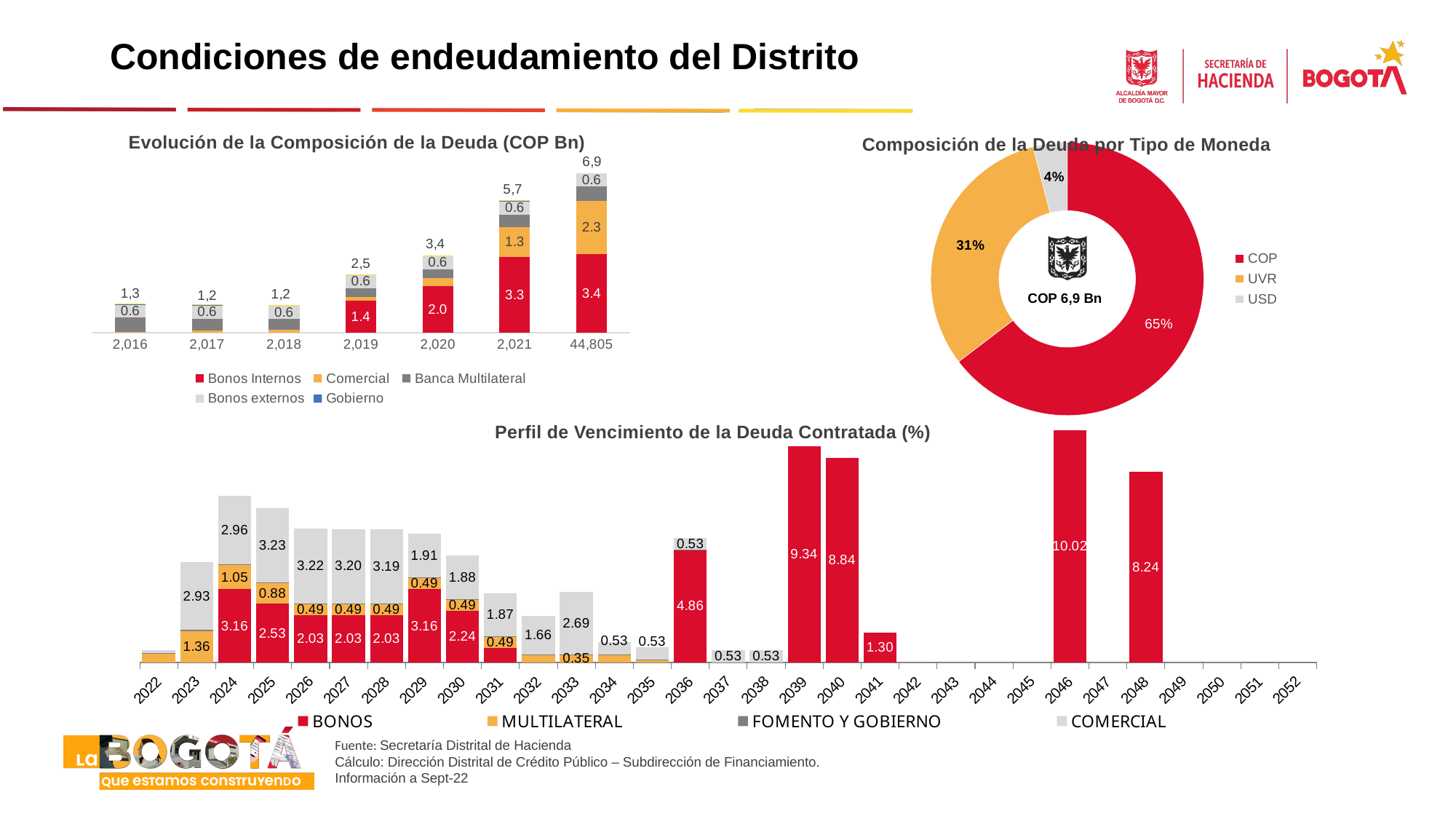
In the 'Composición de la Deuda por Tipo de Moneda' chart, what is the difference between the COP share and the UVR share? 34% In the 'Evolución de la Composición de la Deuda (COP Bn)' chart, what is the Bonos Internos value for 2,020? 2.0 In the 'Evolución de la Composición de la Deuda (COP Bn)' chart, what is the total debt shown for 2,021? 5,7 In the 'Perfil de Vencimiento de la Deuda Contratada (%)' chart, what is the difference between the BONOS values for 2039 and 2040? 0.50 In the 'Composición de la Deuda por Tipo de Moneda' chart, what share of the debt is in COP? 65% What kind of chart is 'Perfil de Vencimiento de la Deuda Contratada (%)'? stacked bar chart In the 'Perfil de Vencimiento de la Deuda Contratada (%)' chart, what is the BONOS value for 2046? 10.02 How many series does the legend of the 'Perfil de Vencimiento de la Deuda Contratada (%)' chart list? 4 In the 'Perfil de Vencimiento de la Deuda Contratada (%)' chart, which year has the highest BONOS value? 2046 In the 'Composición de la Deuda por Tipo de Moneda' chart, which currency has the smallest share? USD In the 'Evolución de la Composición de la Deuda (COP Bn)' chart, do the total values generally rise or fall from left to right? rise How many series does the legend of the 'Evolución de la Composición de la Deuda (COP Bn)' chart list? 5